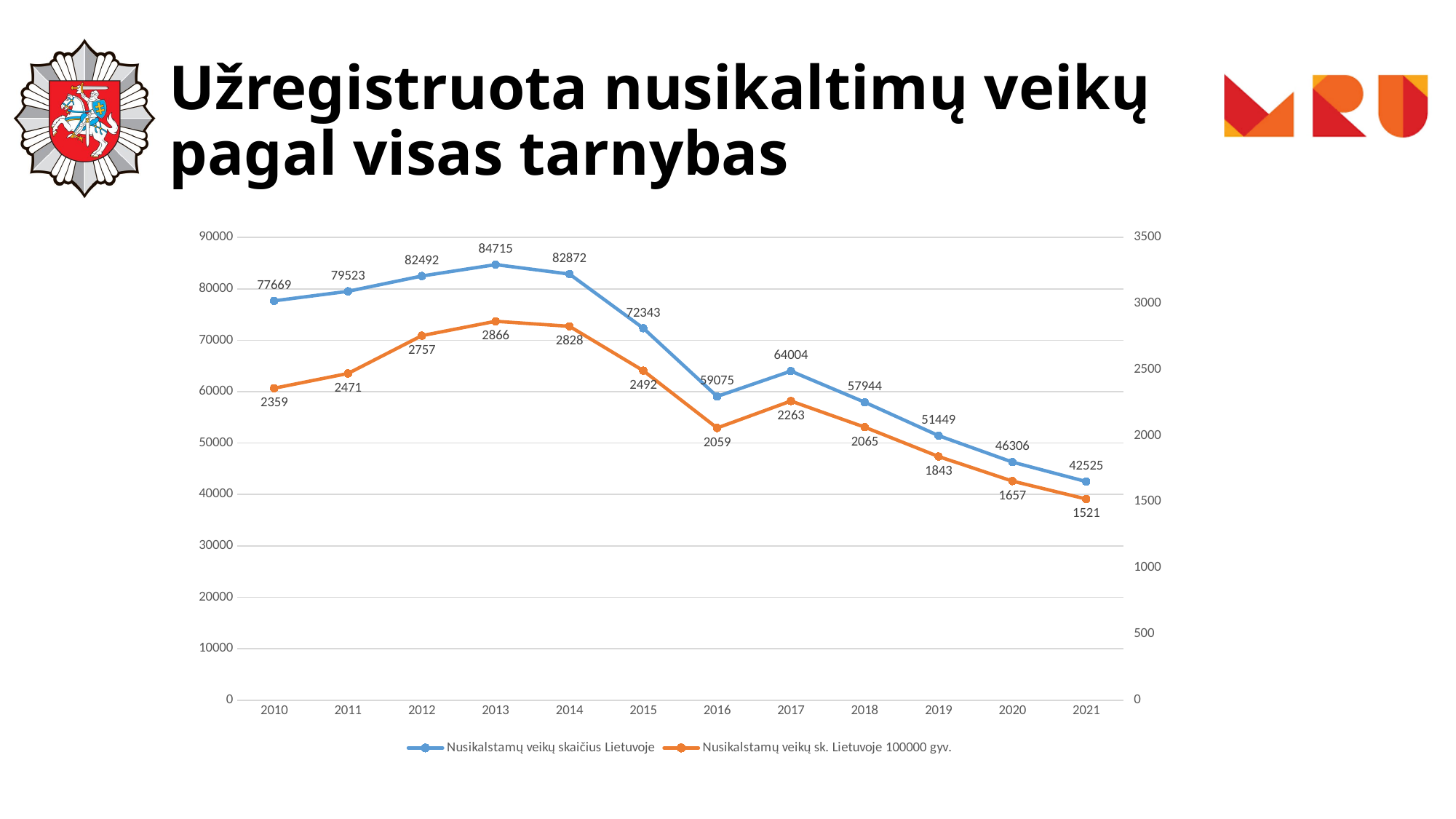
What is the difference between the 'Nusikalstamų veikų skaičius Lietuvoje' values for 2010 and 2021? 35144 What is the value of the 'Nusikalstamų veikų sk. Lietuvoje 100000 gyv.' series in 2021? 1521 In which year does the 'Nusikalstamų veikų skaičius Lietuvoje' series reach its highest value? 2013 Which year has the larger 'Nusikalstamų veikų sk. Lietuvoje 100000 gyv.' value, 2016 or 2017? 2017 What is the value of the 'Nusikalstamų veikų skaičius Lietuvoje' series in 2013? 84715 What colour is the line for the 'Nusikalstamų veikų sk. Lietuvoje 100000 gyv.' series? Orange In which year does the 'Nusikalstamų veikų sk. Lietuvoje 100000 gyv.' series reach its lowest value? 2021 How many series does the chart legend list? 2 What is the value of the 'Nusikalstamų veikų skaičius Lietuvoje' series in 2017? 64004 Does the 'Nusikalstamų veikų skaičius Lietuvoje' series rise or fall from 2014 to 2021? Fall How many years are shown on the x axis of the chart? 12 What kind of chart is shown on the slide? Line chart